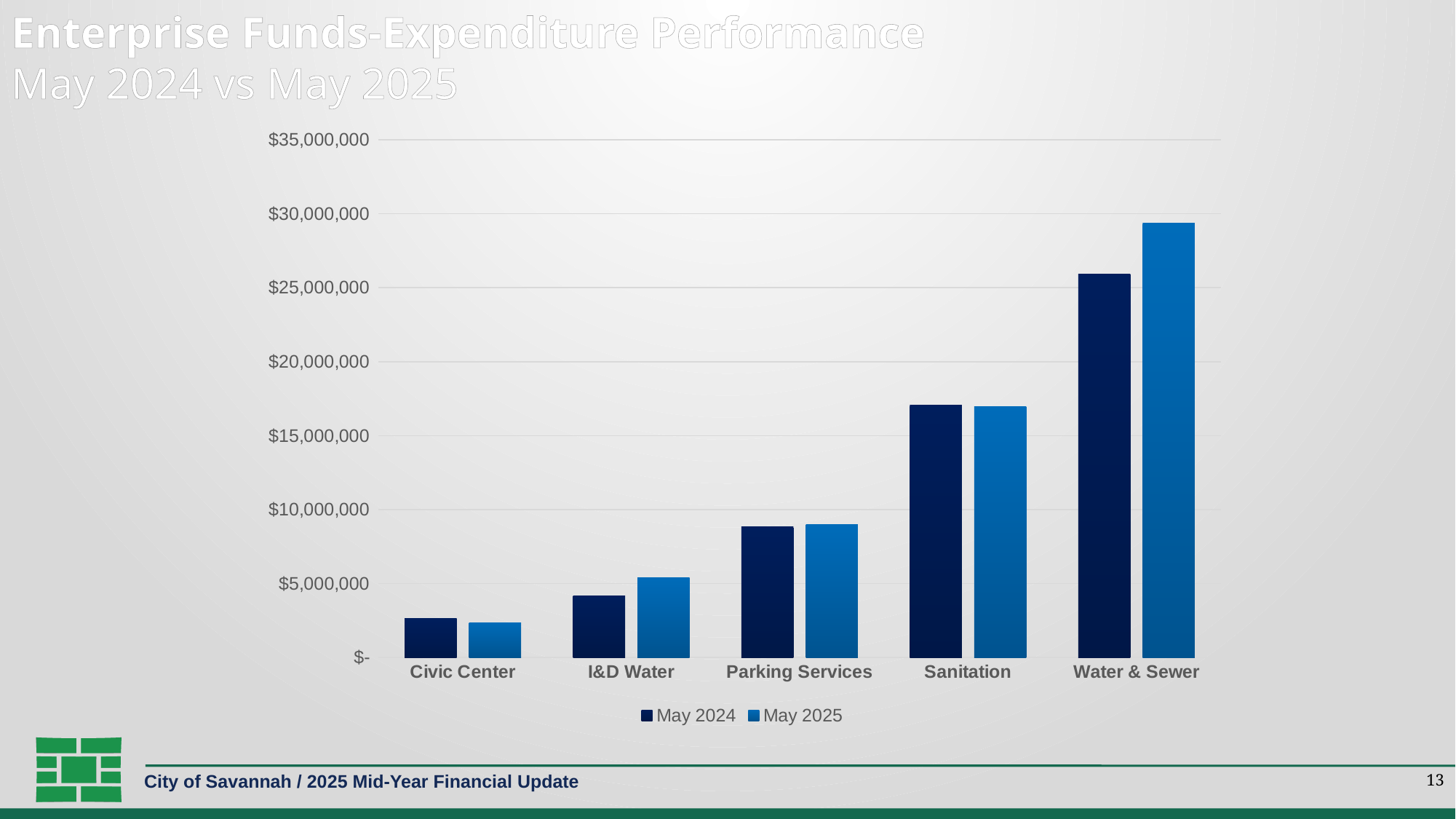
What kind of chart is shown on the slide? Bar chart What are the two entries listed in the legend? May 2024 and May 2025 How many enterprise fund categories are shown on the x axis? 5 Which category has the highest May 2025 expenditure? Water & Sewer Is the May 2024 value for Parking Services greater or less than $10,000,000? less For I&D Water, which is larger: the May 2024 value or the May 2025 value? May 2025 Is the May 2024 value for Water & Sewer greater or less than $25,000,000? greater How many series does the legend list? 2 Which category has the lowest May 2024 expenditure? Civic Center For Water & Sewer, which is larger: the May 2024 value or the May 2025 value? May 2025 Is the May 2025 value for Sanitation greater or less than $20,000,000? less